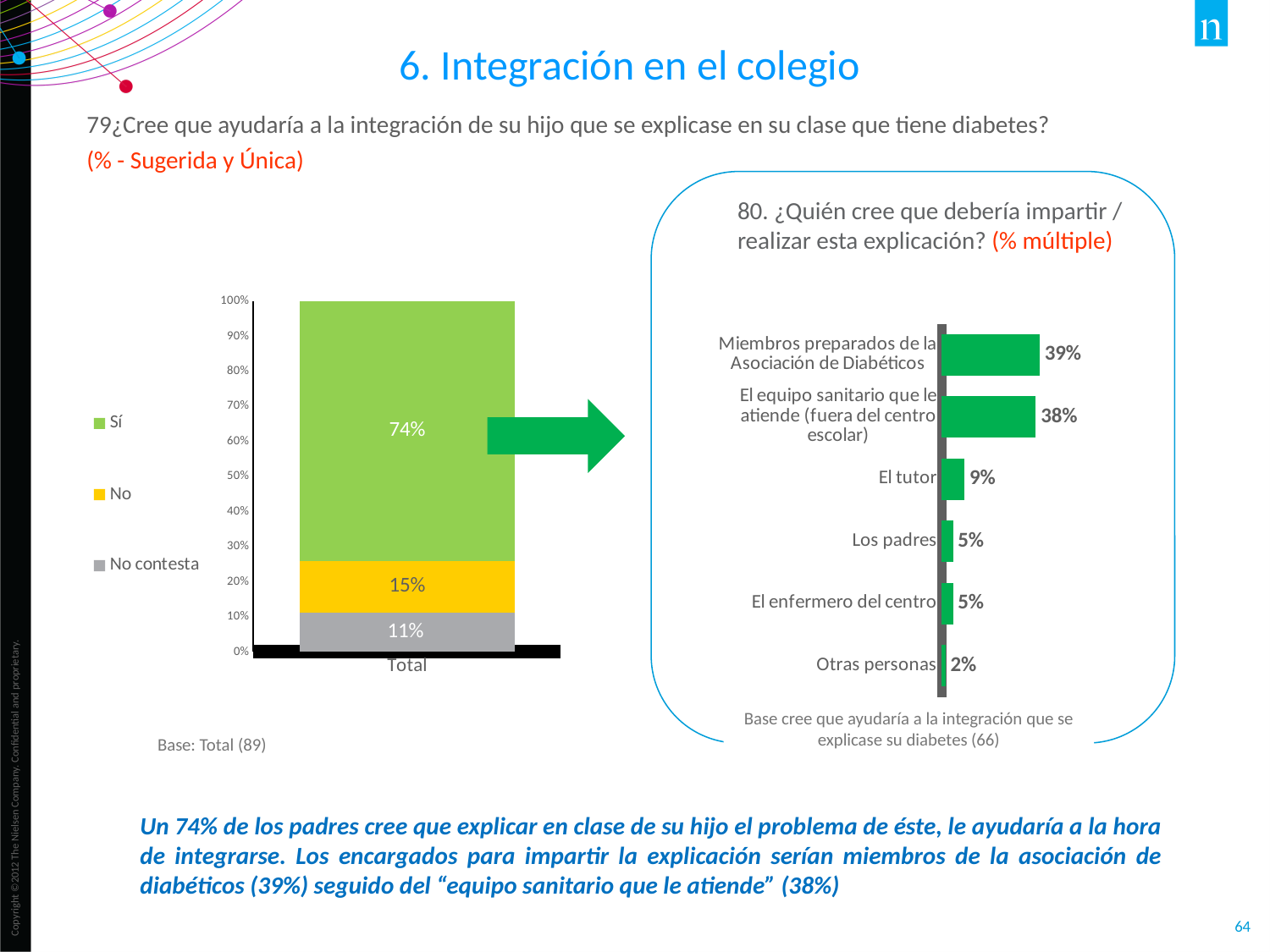
In the stacked bar chart on the left, what percentage answered "No"? 15% In the bar chart on the right, how many categories are shown? 6 What kind of chart is the chart on the right? Bar chart In the stacked bar chart on the left, what percentage answered "Sí"? 74% In the stacked bar chart on the left, how many series does the legend list? 3 In the stacked bar chart on the left, what percentage is "No contesta"? 11% In the stacked bar chart on the left, what is the difference between the "Sí" and "No" percentages? 59% In the bar chart on the right, what is the value for "El tutor"? 9% In the bar chart on the right, what is the value for "Miembros preparados de la Asociación de Diabéticos"? 39% In the stacked bar chart on the left, what is the total of the three segments of the "Total" bar? 100% In the bar chart on the right, what is the difference between "El tutor" and "Los padres"? 4% In the bar chart on the right, which category has the lowest value? Otras personas